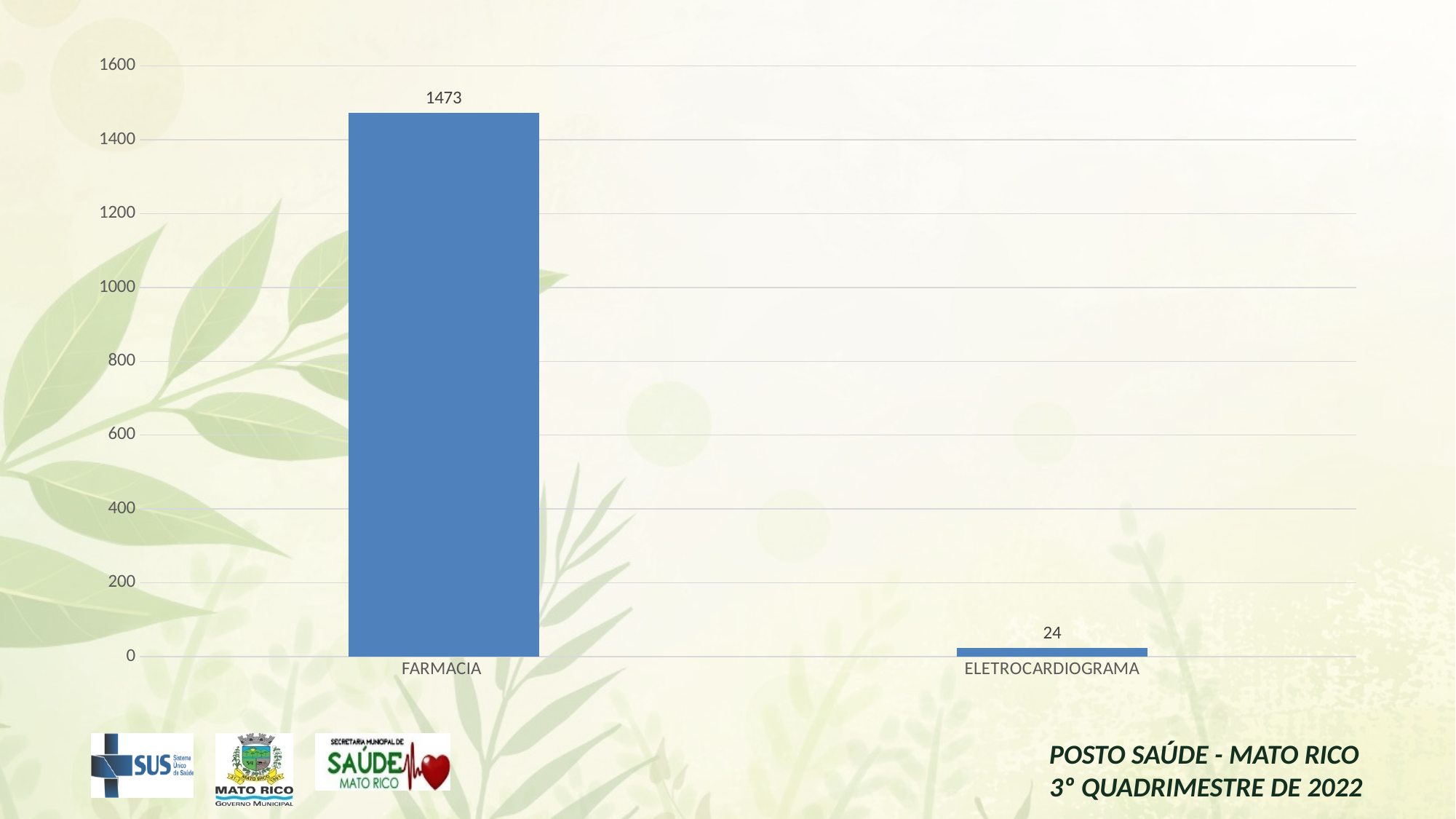
Which category has the highest value? FARMACIA What kind of chart is shown on the slide? bar chart Which is larger, the value for FARMACIA or the value for ELETROCARDIOGRAMA? FARMACIA Which category has the lowest value? ELETROCARDIOGRAMA What is the value for ELETROCARDIOGRAMA? 24 Is the value for ELETROCARDIOGRAMA greater or less than 200? less What is the difference between the values for FARMACIA and ELETROCARDIOGRAMA? 1449 What is the value for FARMACIA? 1473 How many categories are shown on the chart? 2 What is the highest value shown on the vertical axis? 1600 What colour are the bars in the chart? blue Is the value for FARMACIA greater or less than 1400? greater